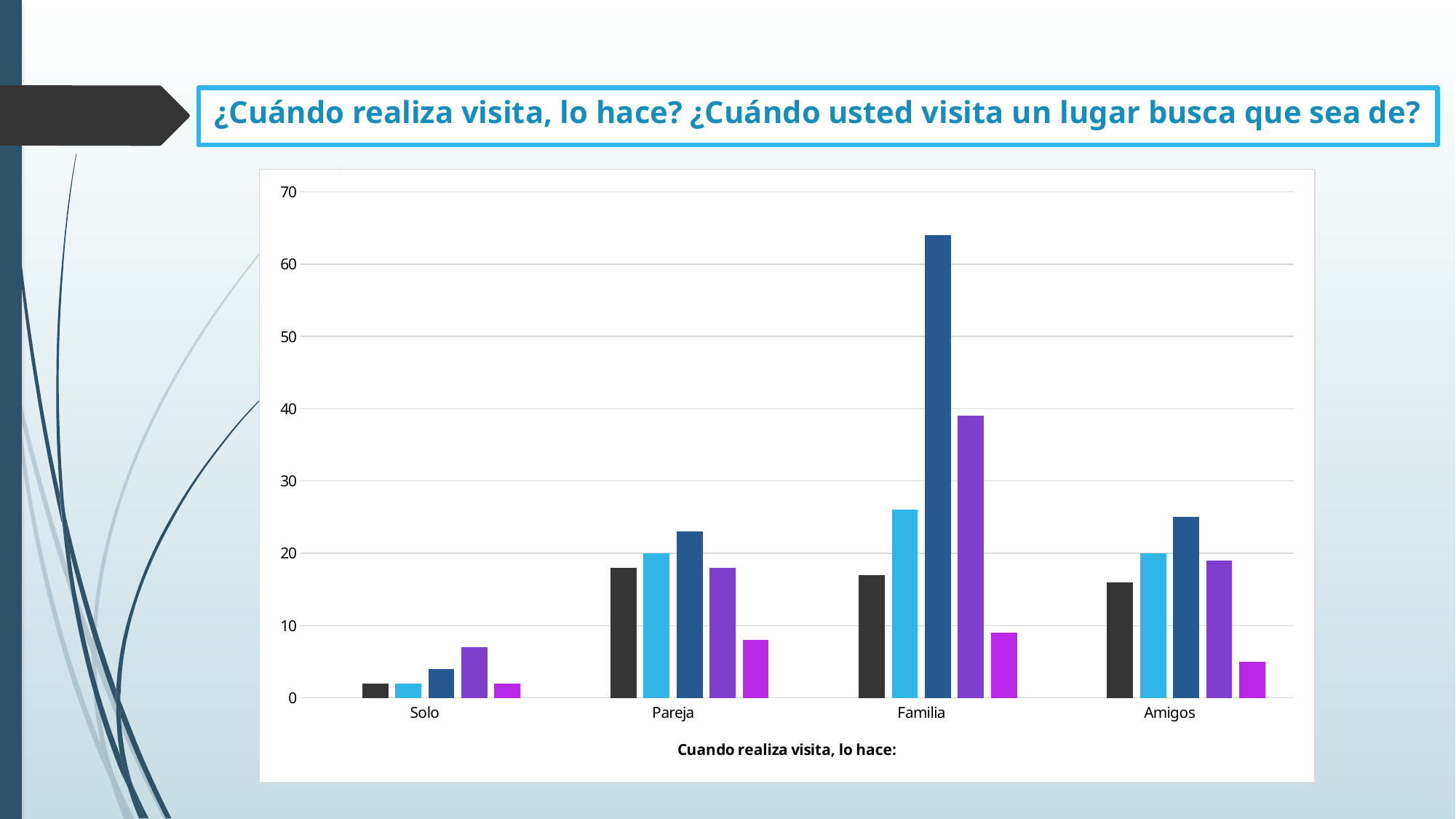
Which category contains the tallest bar in the chart? Familia What is the title shown below the x axis of the chart? Cuando realiza visita, lo hace: Is the value of the dark blue bar for Familia greater or less than 60? greater Is the value of the light blue bar for Familia greater or less than 30? less Is the value of the magenta bar for Pareja greater or less than 10? less How many bars are plotted for each category in the chart? 5 Which category has the lowest bars overall in the chart? Solo For the Solo category, which is larger: the purple bar or the dark blue bar? the purple bar How many categories are shown on the x axis of the chart? 4 What kind of chart is shown on the slide? bar chart